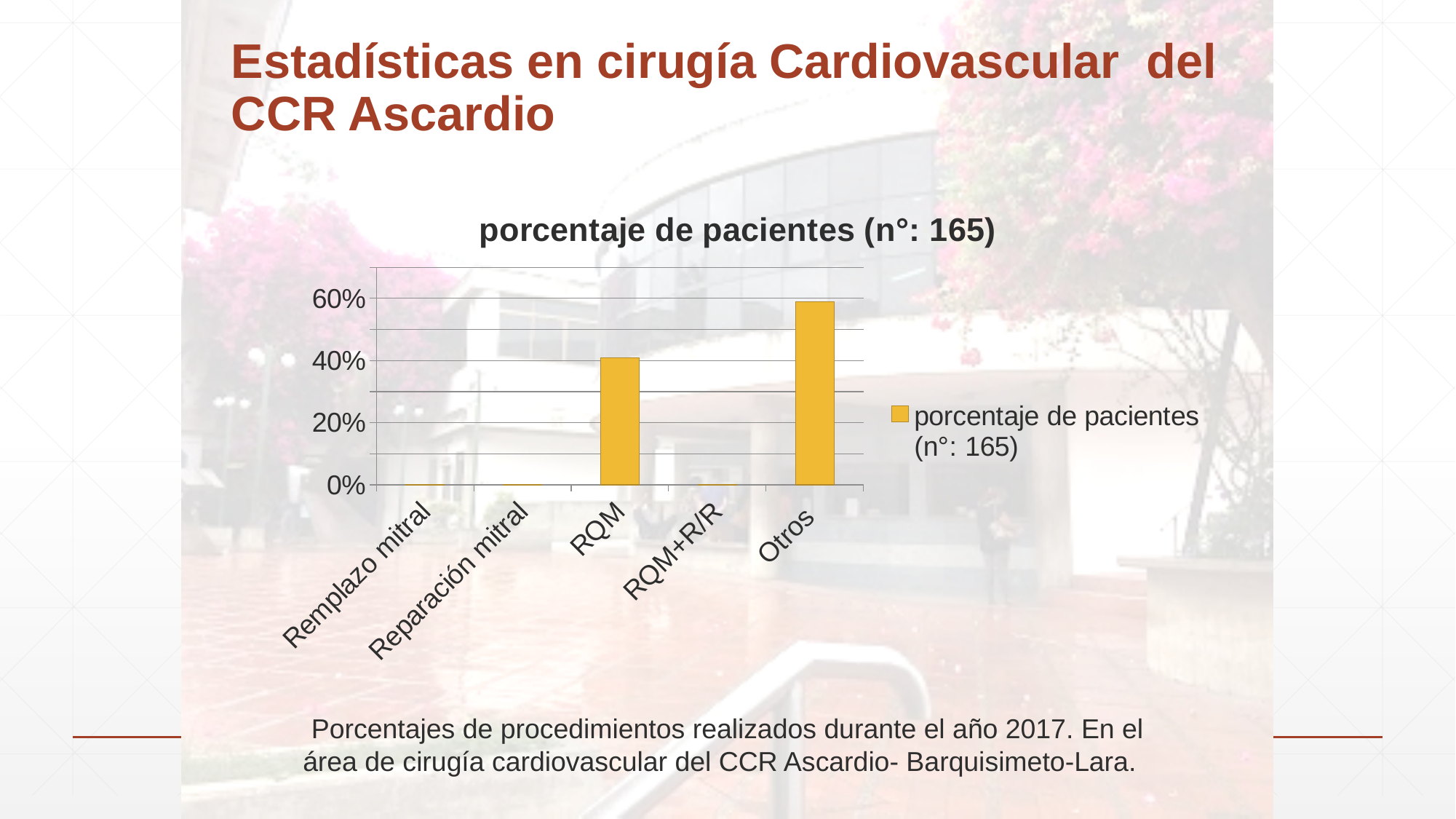
Is the value for Reparación mitral greater or less than 20%? less Which is larger, the value for RQM or the value for RQM+R/R? RQM What is the legend entry shown in the chart? porcentaje de pacientes (n°: 165) What is the title of the chart? porcentaje de pacientes (n°: 165) Is the value for RQM greater or less than 20%? greater Is the value for RQM greater or less than 60%? less Which category has the highest value in the chart? Otros Which is larger, the value for RQM or the value for Otros? Otros What kind of chart is shown on the slide? bar chart How many series does the chart legend list? 1 How many categories are shown on the x axis of the chart? 5